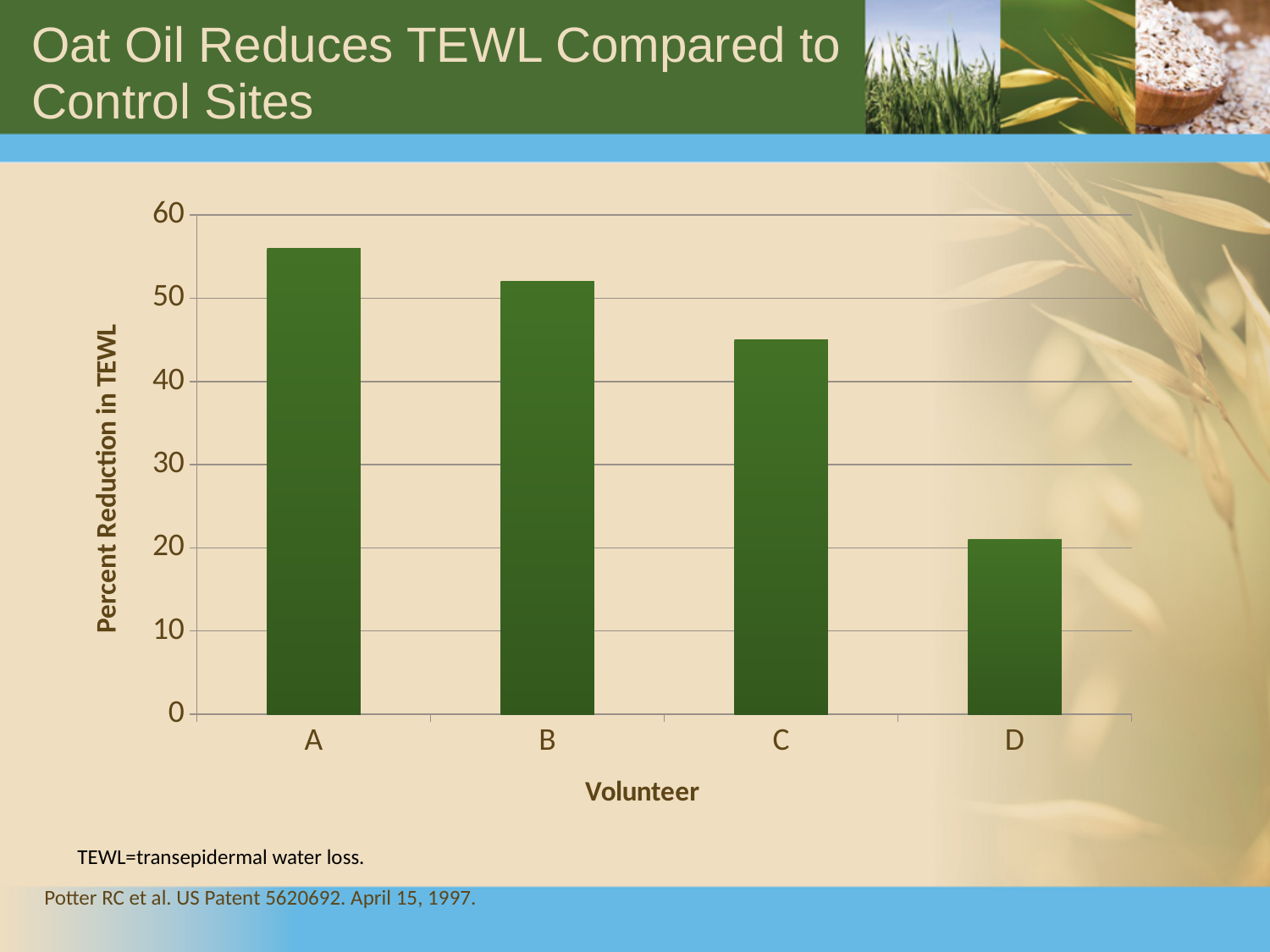
What kind of chart is shown on the slide? bar chart How many volunteers are shown on the x axis of the chart? 4 What is the label of the x axis of the chart? Volunteer Which volunteer has the lowest percent reduction in TEWL? D Is the percent reduction in TEWL for volunteer C greater or less than 40? greater Is the percent reduction in TEWL for volunteer B greater or less than 60? less What is the label of the y axis of the chart? Percent Reduction in TEWL Which volunteer has a larger percent reduction in TEWL, C or D? C Is the percent reduction in TEWL for volunteer D greater or less than 30? less Do the bar values rise or fall from volunteer A to volunteer D? fall Which volunteer has the highest percent reduction in TEWL? A